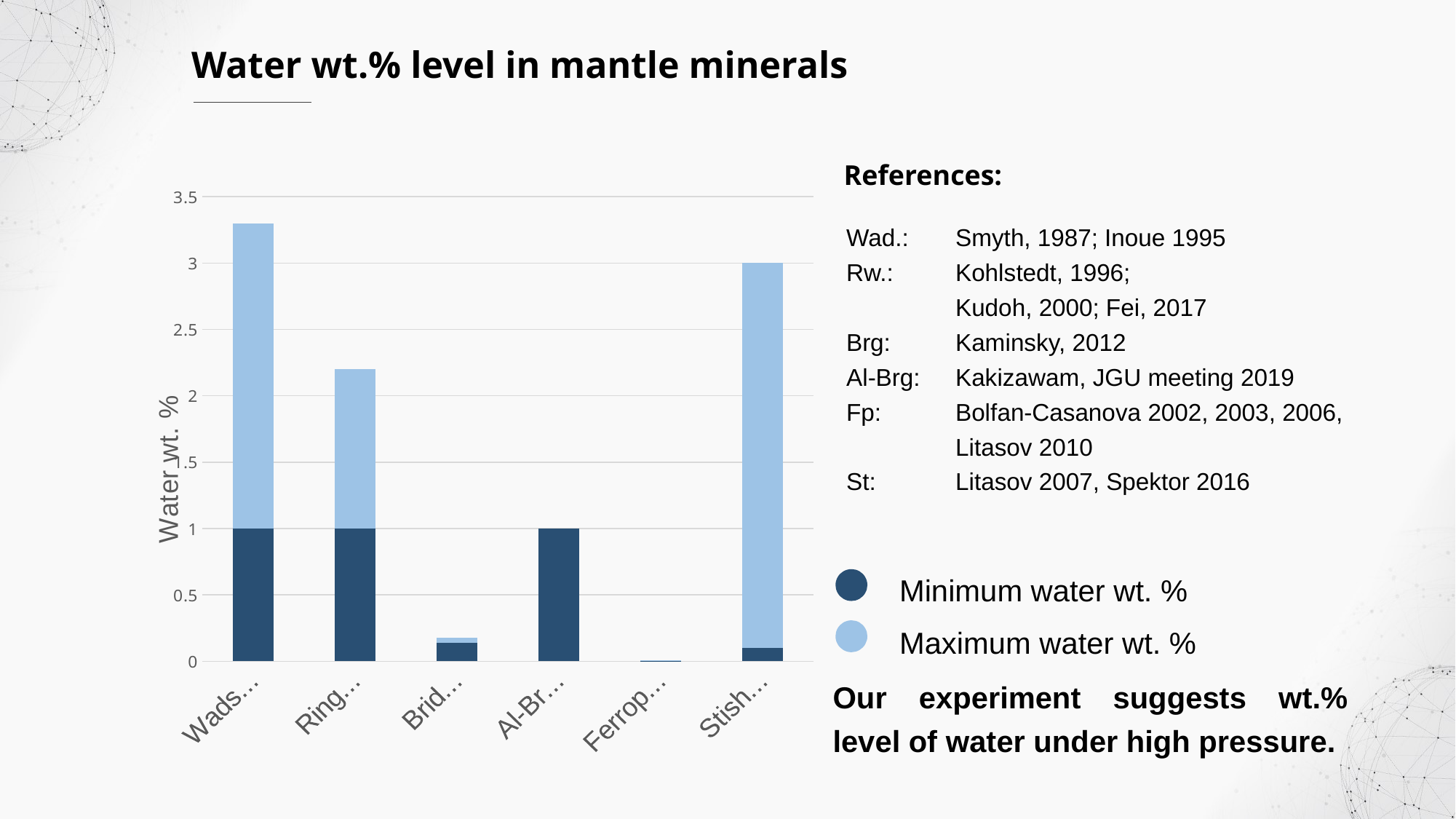
How many series does the legend list? 2 What is the Minimum water wt. % value for Al-Br…? 1 What kind of chart is shown on the slide? bar chart Which category has the shortest stacked bar? Ferrop… What is the label on the y axis? Water wt. % Is the top of the stacked bar for Brid… greater or less than 0.5? less Is the top of the stacked bar for Wads… greater or less than 3? greater Which series is shown in the dark blue colour? Minimum water wt. % Which stacked bar is taller, Ring… or Stish…? Stish… Is the top of the stacked bar for Ring… greater or less than 2? greater Which category has the tallest stacked bar? Wads… How many mineral categories are plotted along the x axis? 6